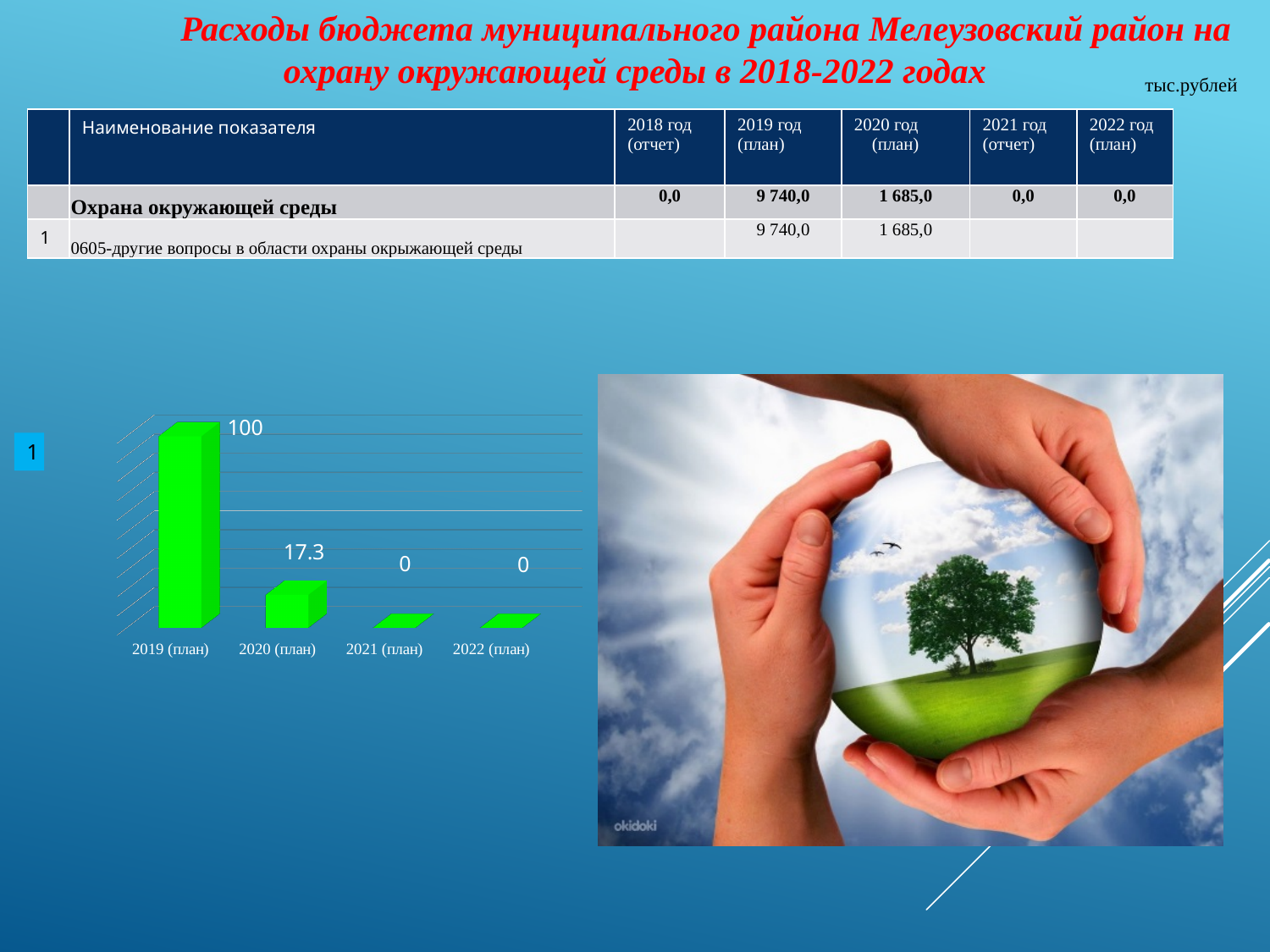
What is the difference between the values for 2019 (план) and 2020 (план) in the bar chart? 82.7 Which is larger in the bar chart, the value for 2019 (план) or the value for 2020 (план)? 2019 (план) Which category has the highest value in the bar chart? 2019 (план) Do the values in the bar chart rise or fall from 2019 (план) to 2022 (план)? Fall What colour are the bars in the bar chart? Green What is the difference between the values for 2020 (план) and 2021 (план) in the bar chart? 17.3 What is the value shown for 2019 (план) in the bar chart? 100 What is the value shown for 2020 (план) in the bar chart? 17.3 What is the value shown for 2022 (план) in the bar chart? 0 What kind of chart is shown on the slide? Bar chart How many categories are shown on the x axis of the bar chart? 4 What is the value shown for 2021 (план) in the bar chart? 0